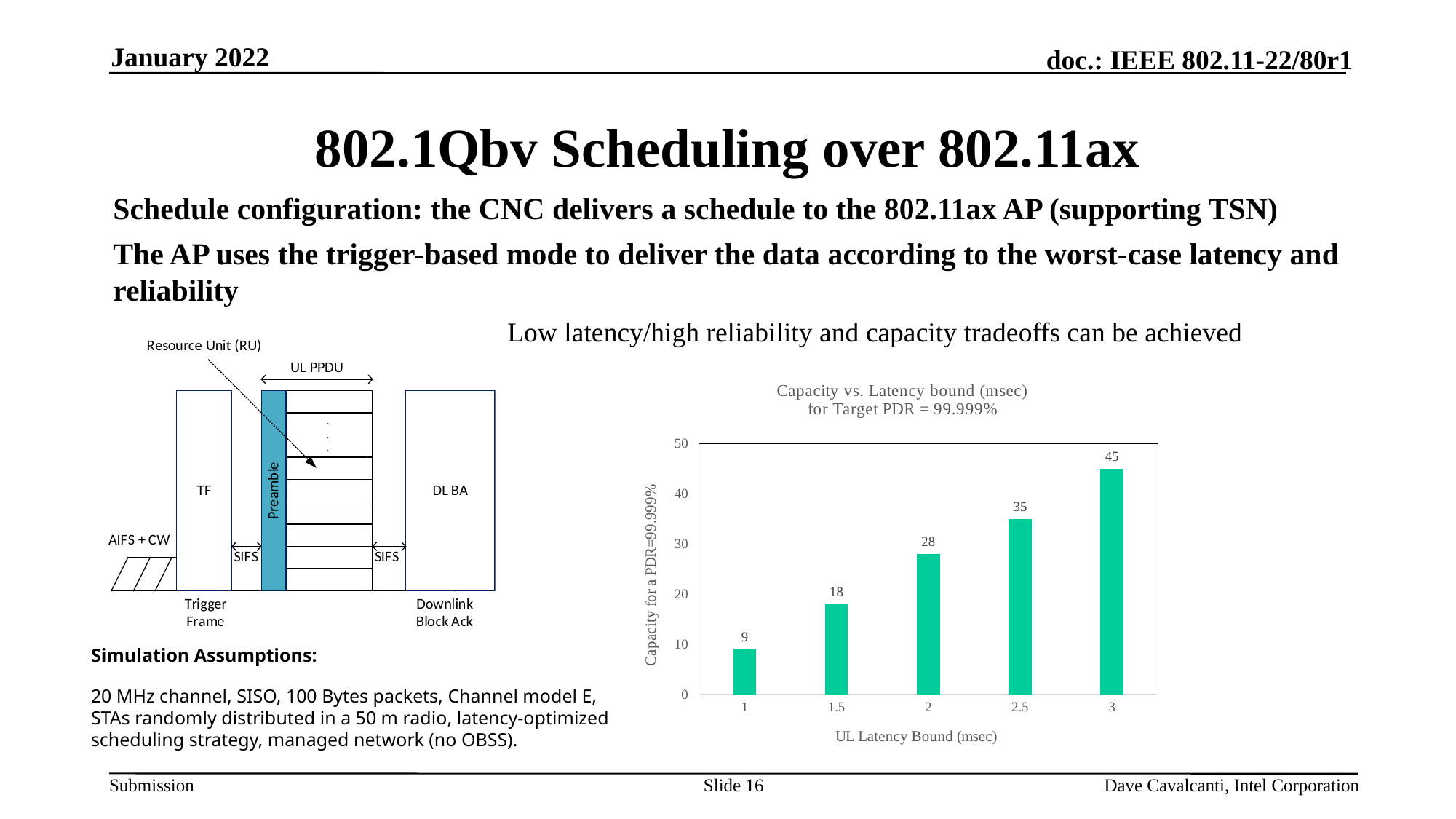
What kind of chart is shown on the slide? bar chart Which has a larger capacity: a latency bound of 1.5 msec or 2.5 msec? 2.5 What is the difference in capacity between a latency bound of 2 msec and 1.5 msec? 10 What is the capacity for a UL latency bound of 1 msec? 9 Which UL latency bound has the highest capacity? 3 Which UL latency bound has the lowest capacity? 1 How many latency bound values are plotted in the chart? 5 Does capacity rise or fall as the UL latency bound increases? rise What is the capacity for a UL latency bound of 2.5 msec? 35 What is the capacity for a UL latency bound of 2 msec? 28 Is the capacity for a latency bound of 3 msec greater or less than 40? greater What is the difference in capacity between a latency bound of 3 msec and 1 msec? 36